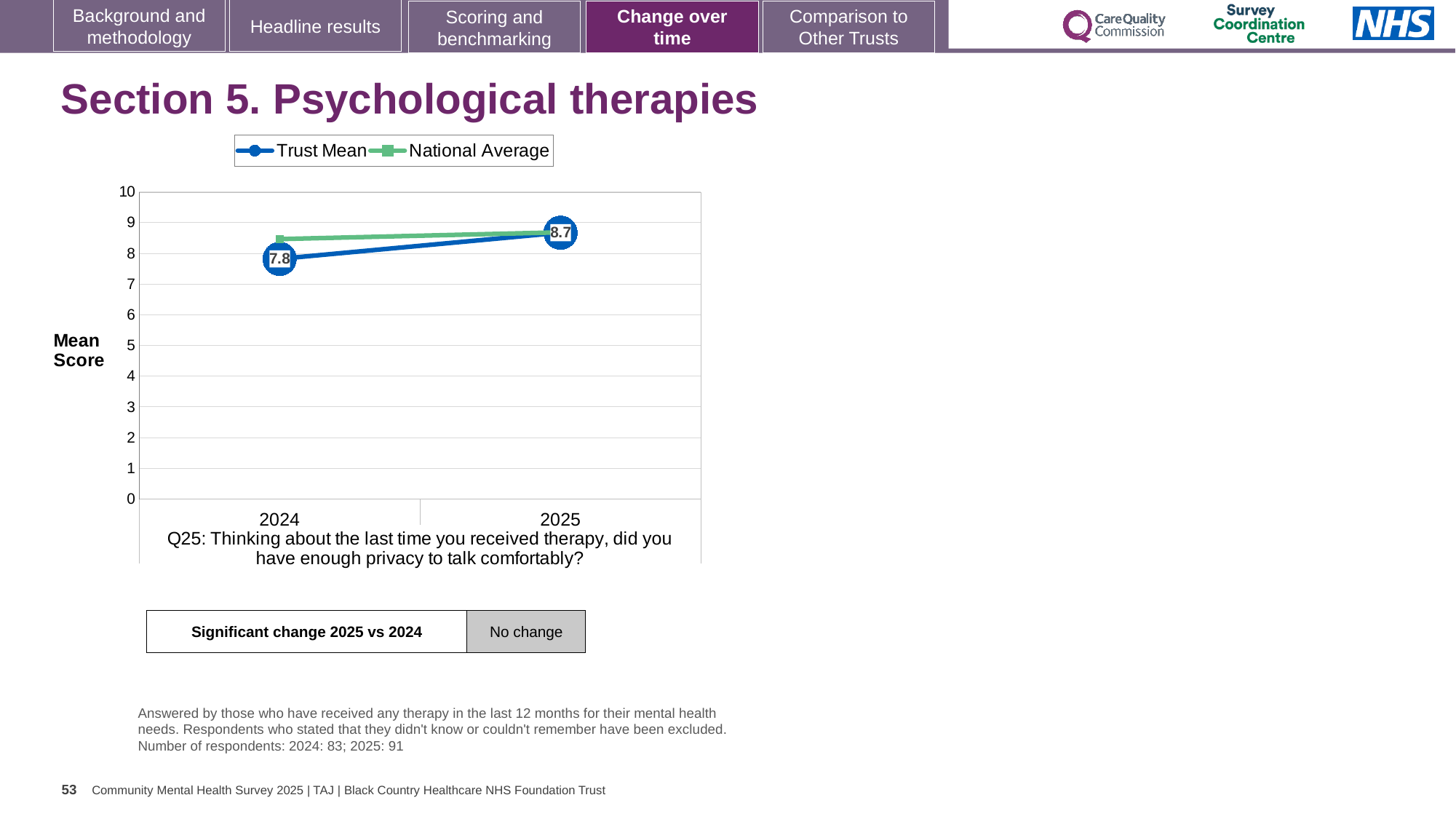
What is the label on the y axis of the chart? Mean Score What is the Trust Mean score for 2024? 7.8 Does the Trust Mean rise or fall from 2024 to 2025? rise How many series does the legend list? 2 What is the Trust Mean score for 2025? 8.7 In 2024, which is higher, the Trust Mean or the National Average? National Average What are the two series named in the legend? Trust Mean and National Average By how much did the Trust Mean score change from 2024 to 2025? 0.9 Is the National Average value for 2024 greater or less than 8? greater How many years are plotted on the x axis? 2 What kind of chart is shown on the slide? line chart Which year has the higher Trust Mean score, 2024 or 2025? 2025